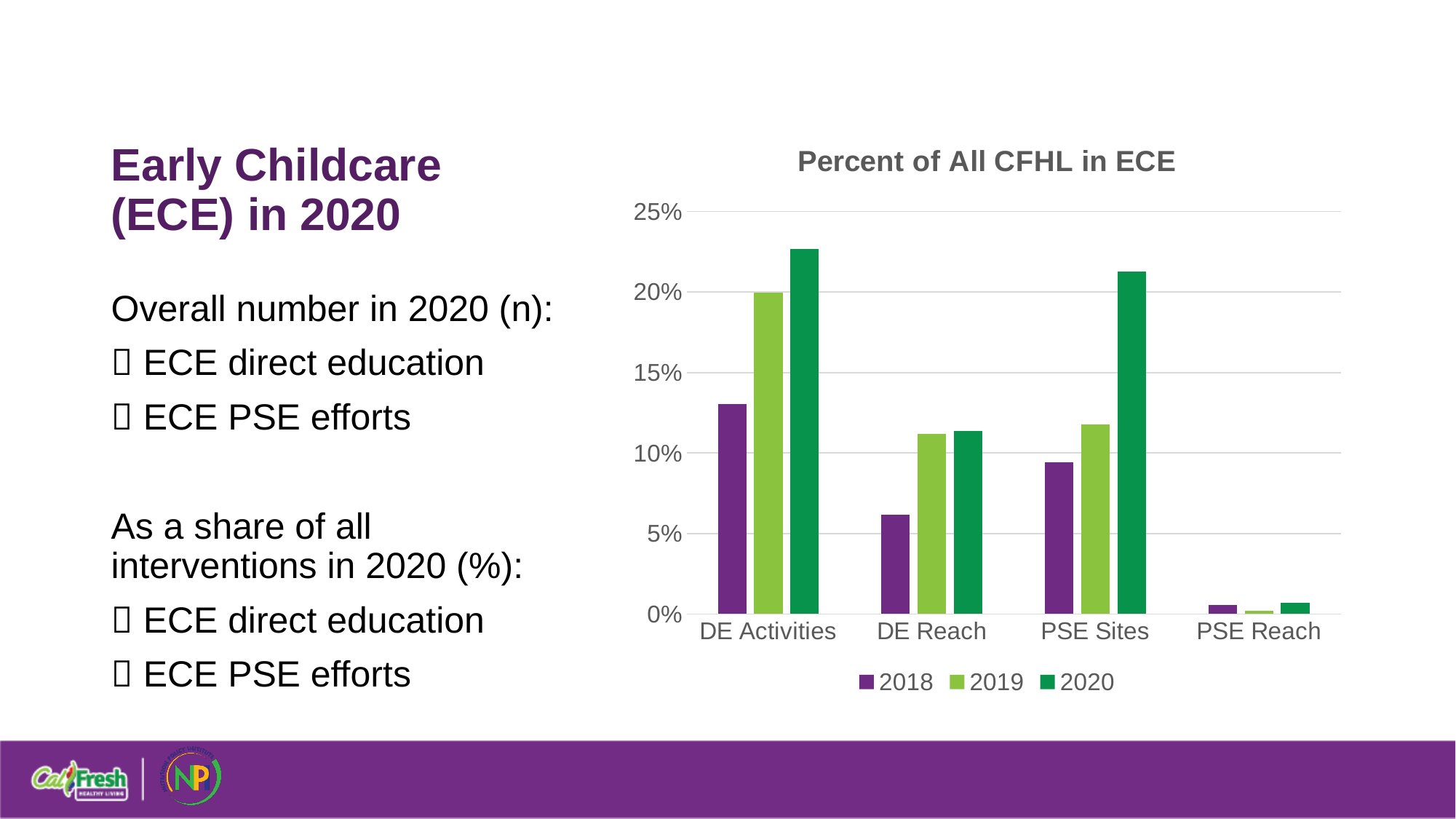
Which is larger, the 2019 value for DE Activities or the 2019 value for PSE Sites? DE Activities Which category has the highest 2020 value? DE Activities Is the 2020 value for PSE Sites greater or less than 20%? greater Is the 2018 value for PSE Sites greater or less than 10%? less Which category has the lowest values across all three years? PSE Reach For DE Activities, do the values rise or fall from 2018 to 2020? rise How many categories are shown on the x axis? 4 How many series does the legend list? 3 Is the 2018 value for DE Reach greater or less than 10%? less What kind of chart is shown on the slide? bar chart What is the title of the chart? Percent of All CFHL in ECE